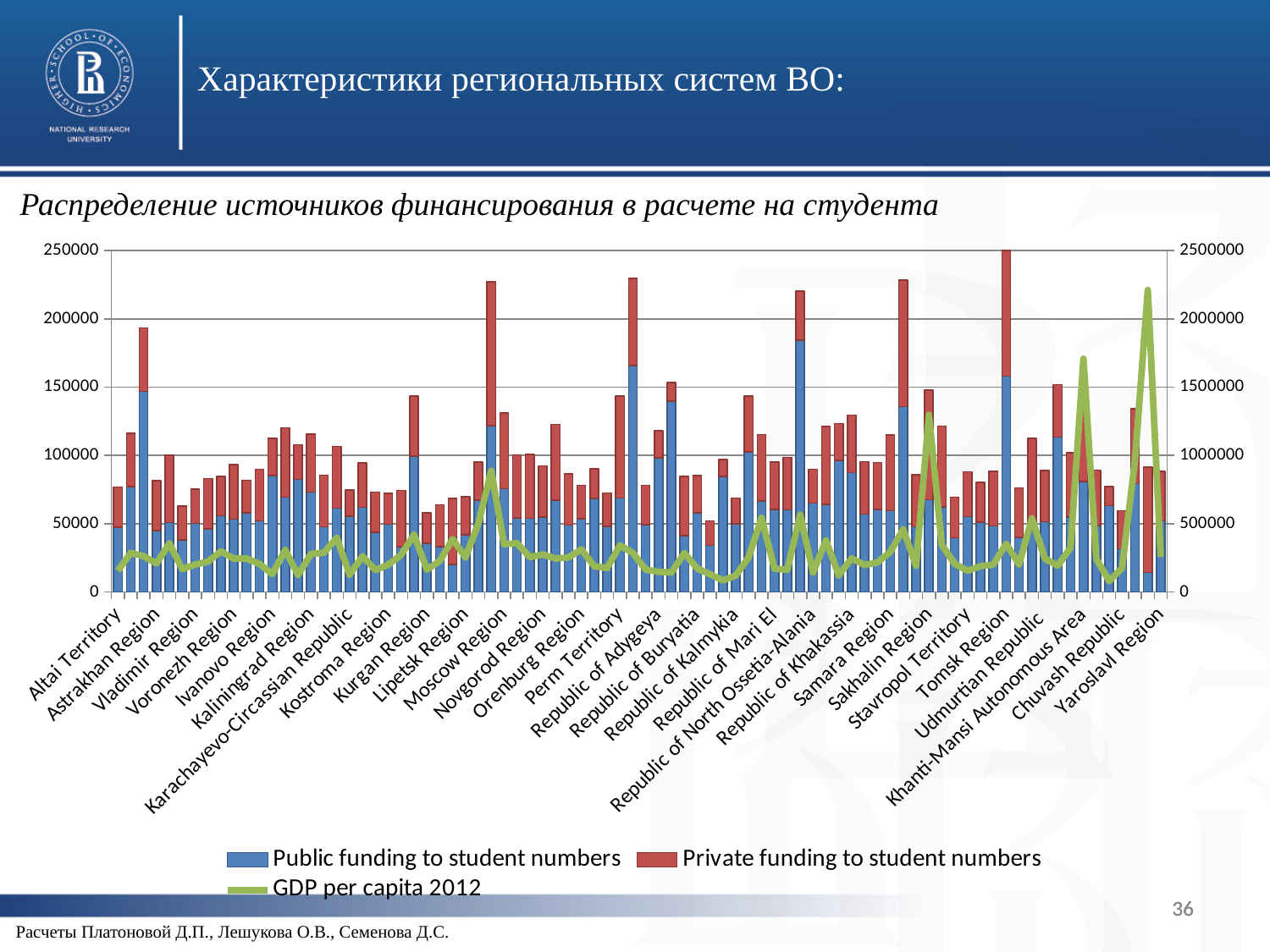
Is the tallest stacked bar total greater or less than 200000? greater Is the total funding per student for Altai Territory greater or less than 100000? less What is the maximum value shown on the left vertical axis? 250000 What is the title of the chart? Распределение источников финансирования в расчете на студента Is the total funding per student for Altai Territory greater or less than 50000? greater What kind of chart is this? Stacked bar chart combined with a line chart What is the maximum value shown on the right vertical axis? 2500000 How many series does the legend list? 3 Which series is plotted as a green line? GDP per capita 2012